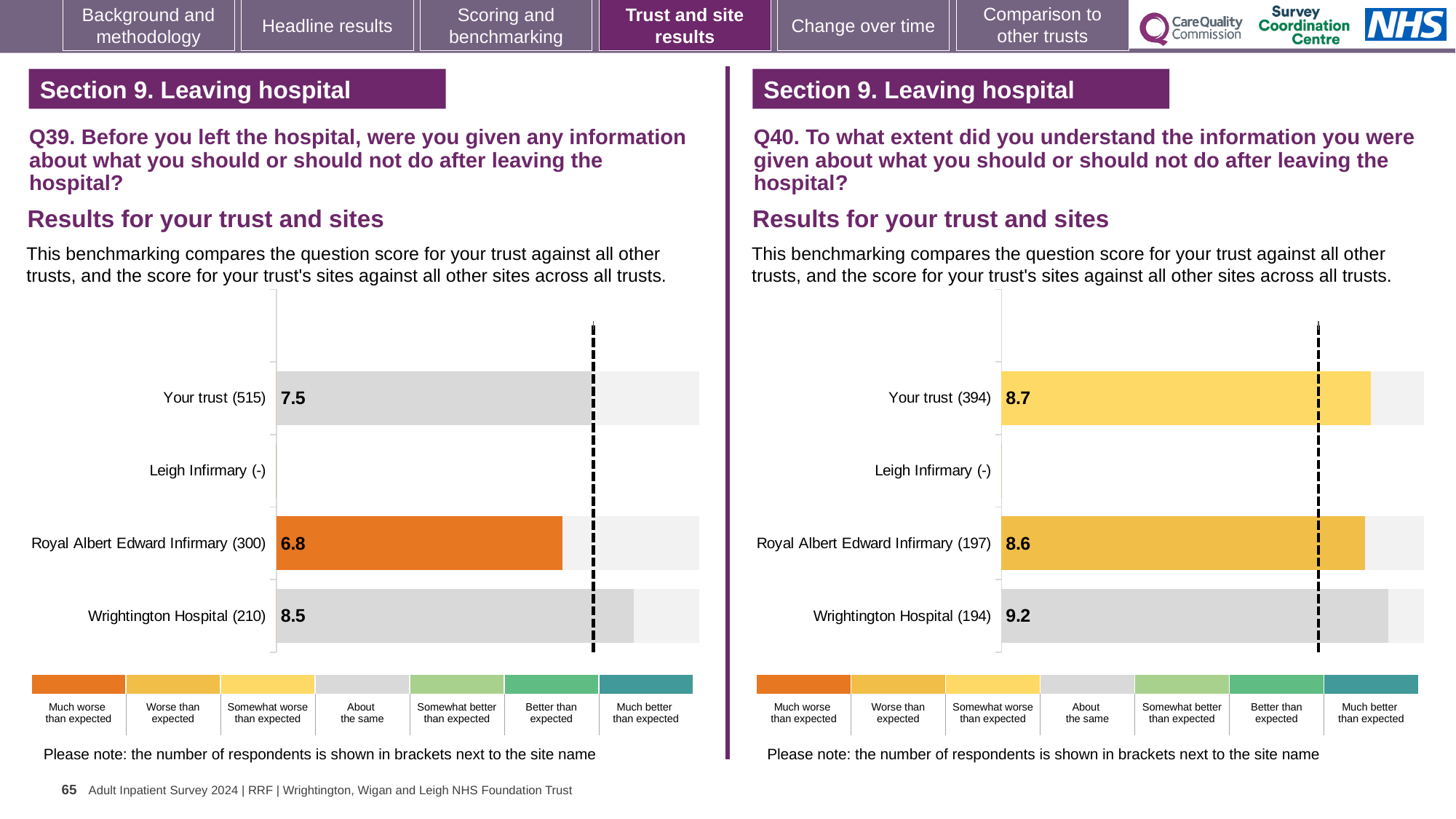
In the Q40 chart on the right, what is the score for Your trust? 8.7 In the Q39 chart on the left, what is the score for Royal Albert Edward Infirmary? 6.8 In the Q39 chart on the left, how many respondents are shown for Your trust? 515 In the Q39 chart on the left, what is the score for Your trust? 7.5 In the Q40 chart on the right, what is the difference between the scores for Wrightington Hospital and Your trust? 0.5 Which is larger: the Q39 score for Your trust or the Q40 score for Your trust? Q40 (8.7) What kind of chart is used on the left for Q39? Bar chart In the Q39 chart on the left, which site has the highest score? Wrightington Hospital In the Q40 chart on the right, which site has the lowest printed score? Royal Albert Edward Infirmary In the Q39 chart on the left, what is the difference between the scores for Wrightington Hospital and Royal Albert Edward Infirmary? 1.7 In the Q40 chart on the right, what is the score for Wrightington Hospital? 9.2 In the Q39 chart on the left, which benchmark category does the colour of the Royal Albert Edward Infirmary bar correspond to? Much worse than expected